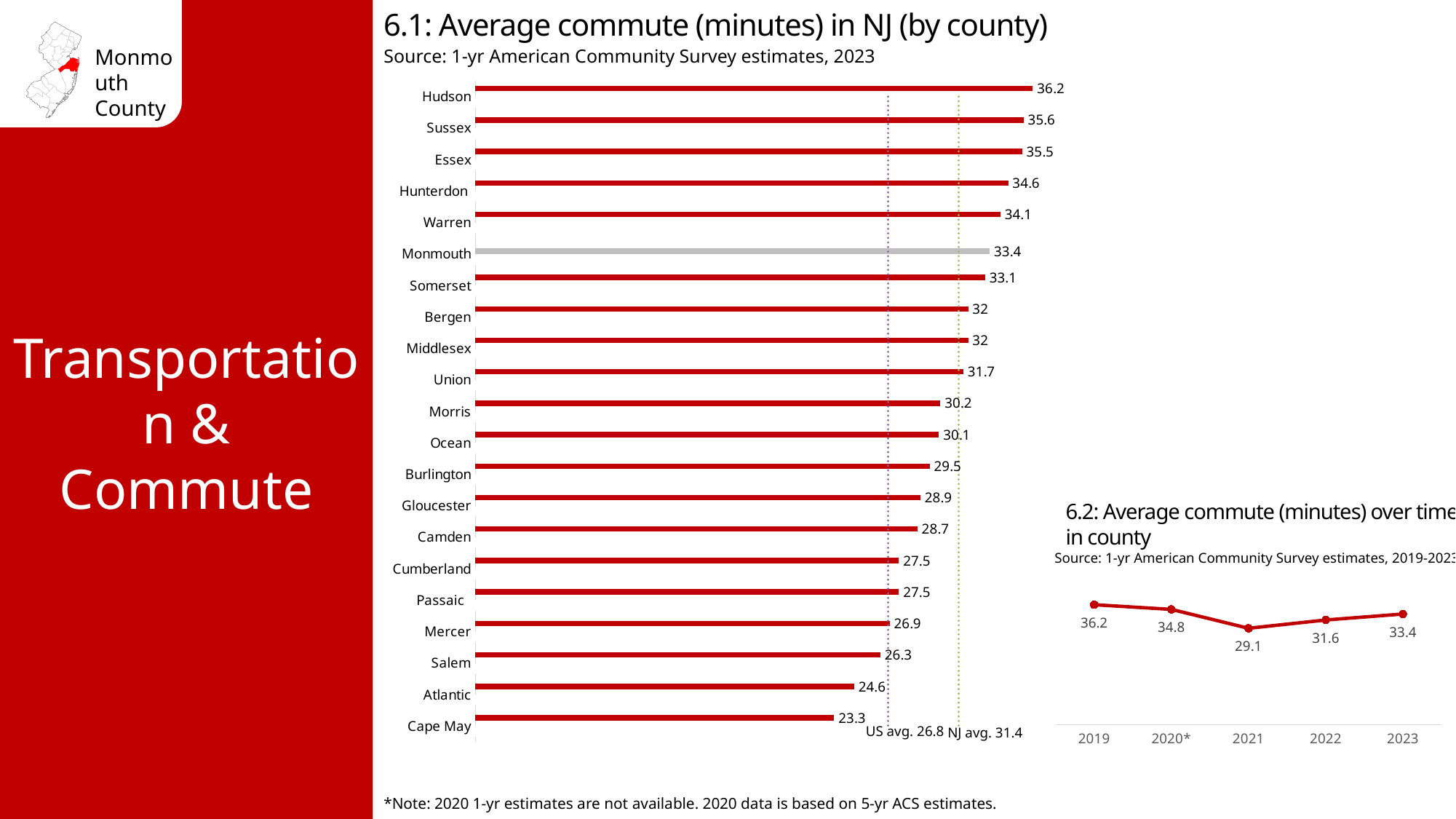
In chart 6.1 (Average commute in NJ by county), what NJ average value is marked by the dotted line? 31.4 In chart 6.1 (Average commute in NJ by county), what is the average commute for Monmouth? 33.4 What kind of chart is chart 6.1 (Average commute in NJ by county)? Bar chart In chart 6.1 (Average commute in NJ by county), what is the difference between Hudson's and Cape May's average commute? 12.9 In chart 6.1 (Average commute in NJ by county), which has a longer average commute, Morris or Ocean? Morris In chart 6.1 (Average commute in NJ by county), which county has the lowest average commute? Cape May In chart 6.2 (Average commute over time in county), which year has the lowest value? 2021 In chart 6.1 (Average commute in NJ by county), what is the average commute for Atlantic? 24.6 In chart 6.2 (Average commute over time in county), what is the difference between the 2019 and 2023 values? 2.8 In chart 6.2 (Average commute over time in county), what is the value for 2021? 29.1 In chart 6.1 (Average commute in NJ by county), which county has the highest average commute? Hudson In chart 6.1 (Average commute in NJ by county), how many counties are shown? 21